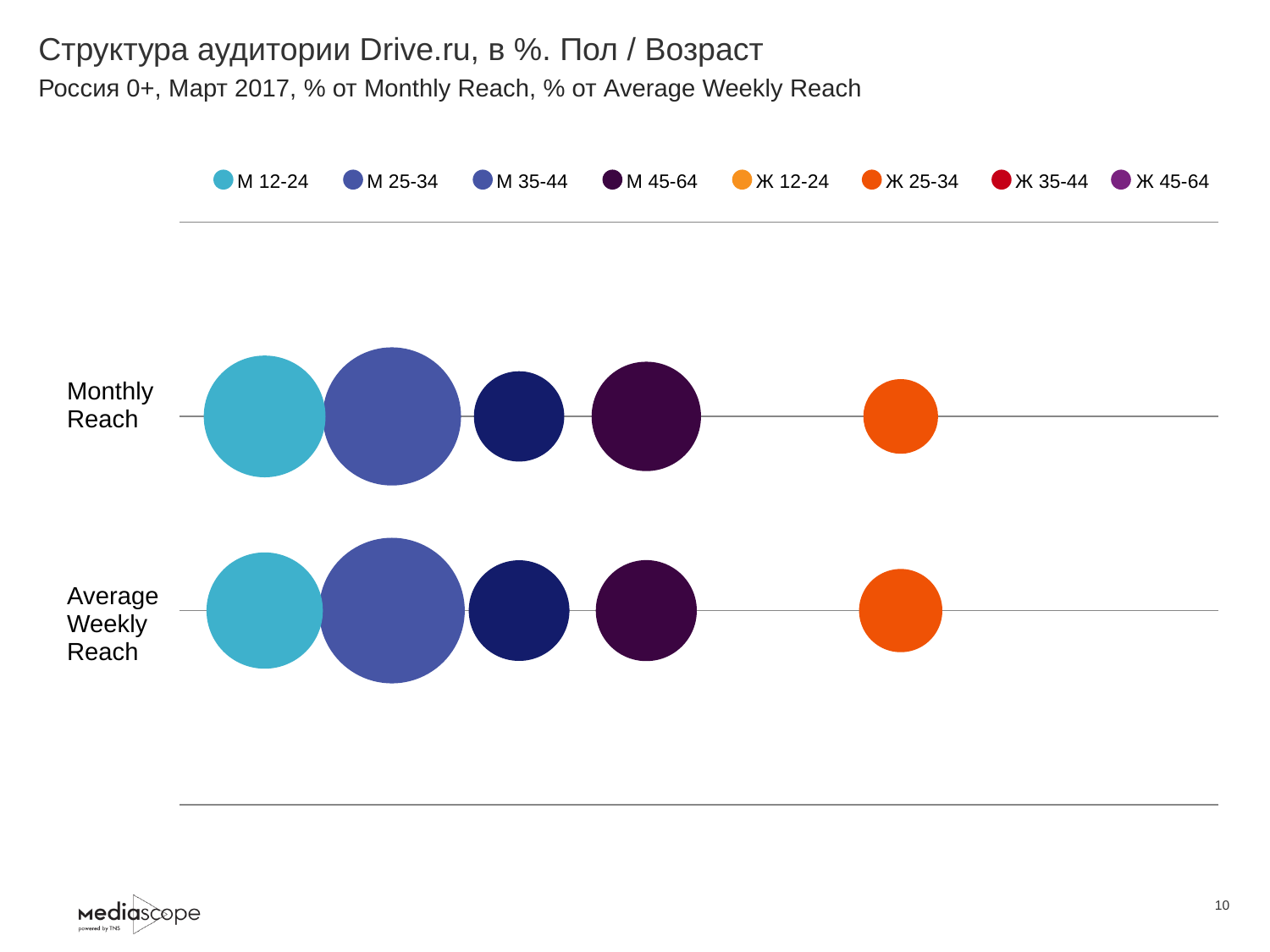
Which series has the largest bubble in the Monthly Reach row? М 25-34 What are the two categories plotted on the chart? Monthly Reach and Average Weekly Reach In the Monthly Reach row, which bubble is larger: М 45-64 or Ж 25-34? М 45-64 What is the title of the chart on the slide? Структура аудитории Drive.ru, в %. Пол / Возраст In the Monthly Reach row, which bubble is larger: М 12-24 or М 45-64? М 12-24 How many series does the legend list? 8 Which series has the largest bubble in the Average Weekly Reach row? М 25-34 How many categories (rows) are plotted on the chart? 2 In the Average Weekly Reach row, which bubble is larger: М 25-34 or М 35-44? М 25-34 What kind of chart is shown on the slide? bubble chart Which of the visible bubbles in the Monthly Reach row is the smallest? Ж 25-34